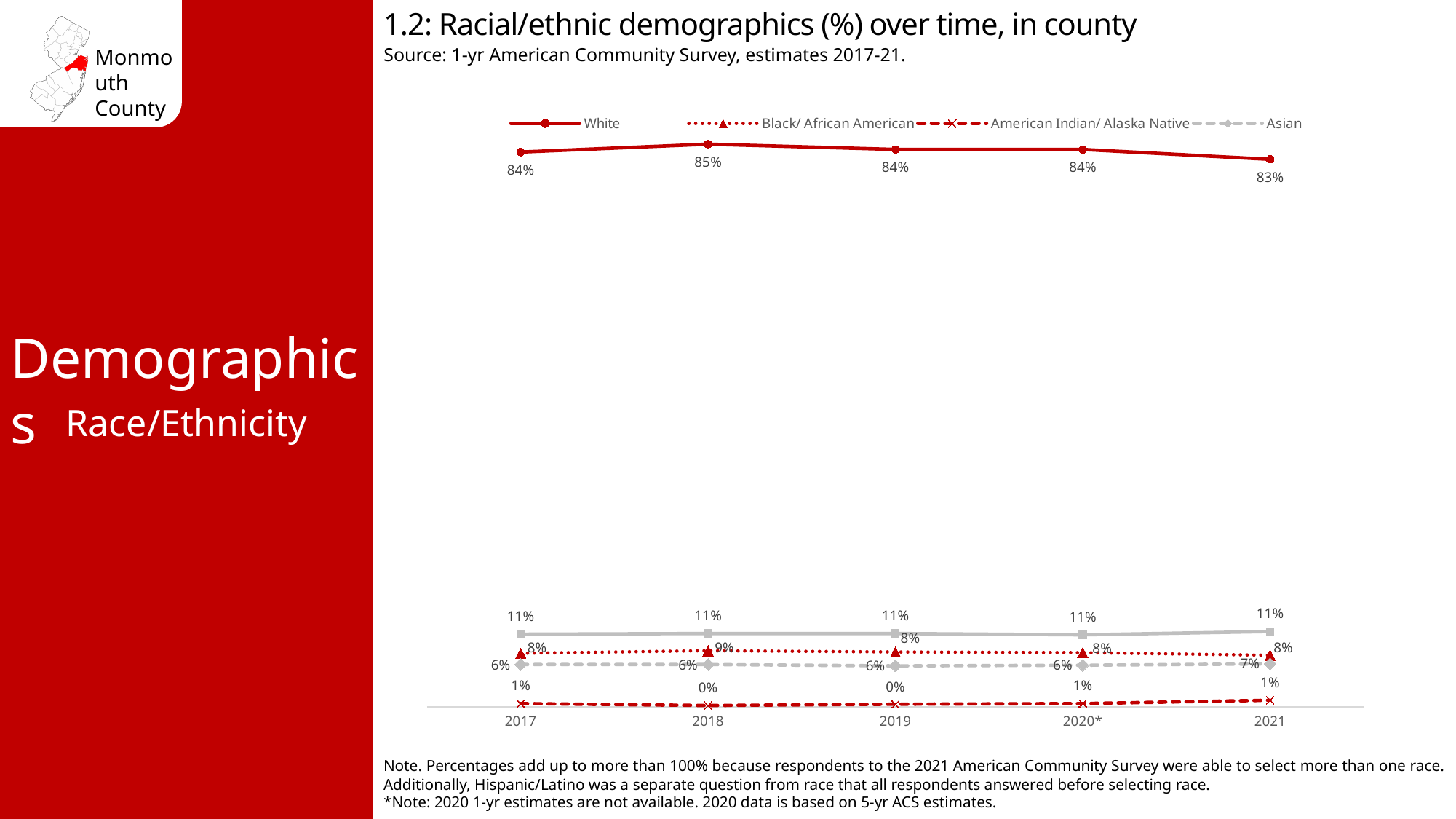
In which year is the Black/ African American percentage highest? 2018 In which year is the White percentage lowest? 2021 What is the title of the chart? 1.2: Racial/ethnic demographics (%) over time, in county What percentage is shown for White in 2018? 85% Does the White percentage rise or fall from 2018 to 2021? Fall What is the difference between the White percentage in 2018 and in 2021? 2% What percentage is shown for American Indian/ Alaska Native in 2019? 0% What percentage is shown for Black/ African American in 2018? 9% What kind of chart is this? Line chart What percentage is shown for Asian in 2021? 7% Which is larger in 2017, the Black/ African American percentage or the Asian percentage? Black/ African American How many years are shown on the x axis? 5